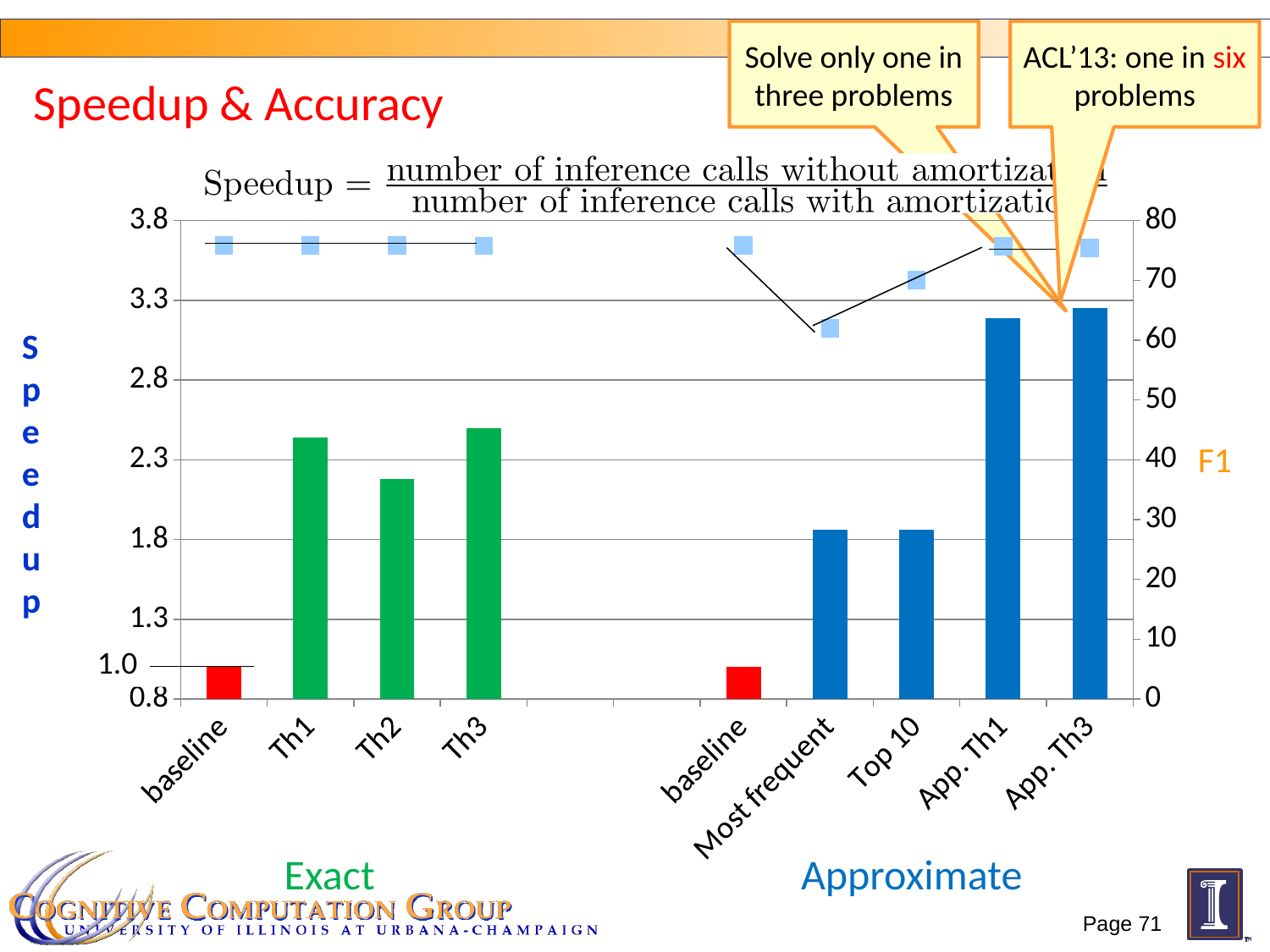
Which has the higher F1, Most frequent or Top 10? Top 10 What kind of chart is shown on the slide? bar chart Is the speedup for Th1 greater or less than 2.3? greater What is the title of the slide containing the chart? Speedup & Accuracy How many categories are shown along the x axis of the chart? 9 Is the speedup for App. Th1 greater or less than 2.8? greater Is the speedup for Th2 greater or less than 2.3? less Which has the higher speedup, App. Th1 or Th3? App. Th1 Which has the higher speedup, Th1 or Th2? Th1 What is the speedup value for the baseline bars? 1.0